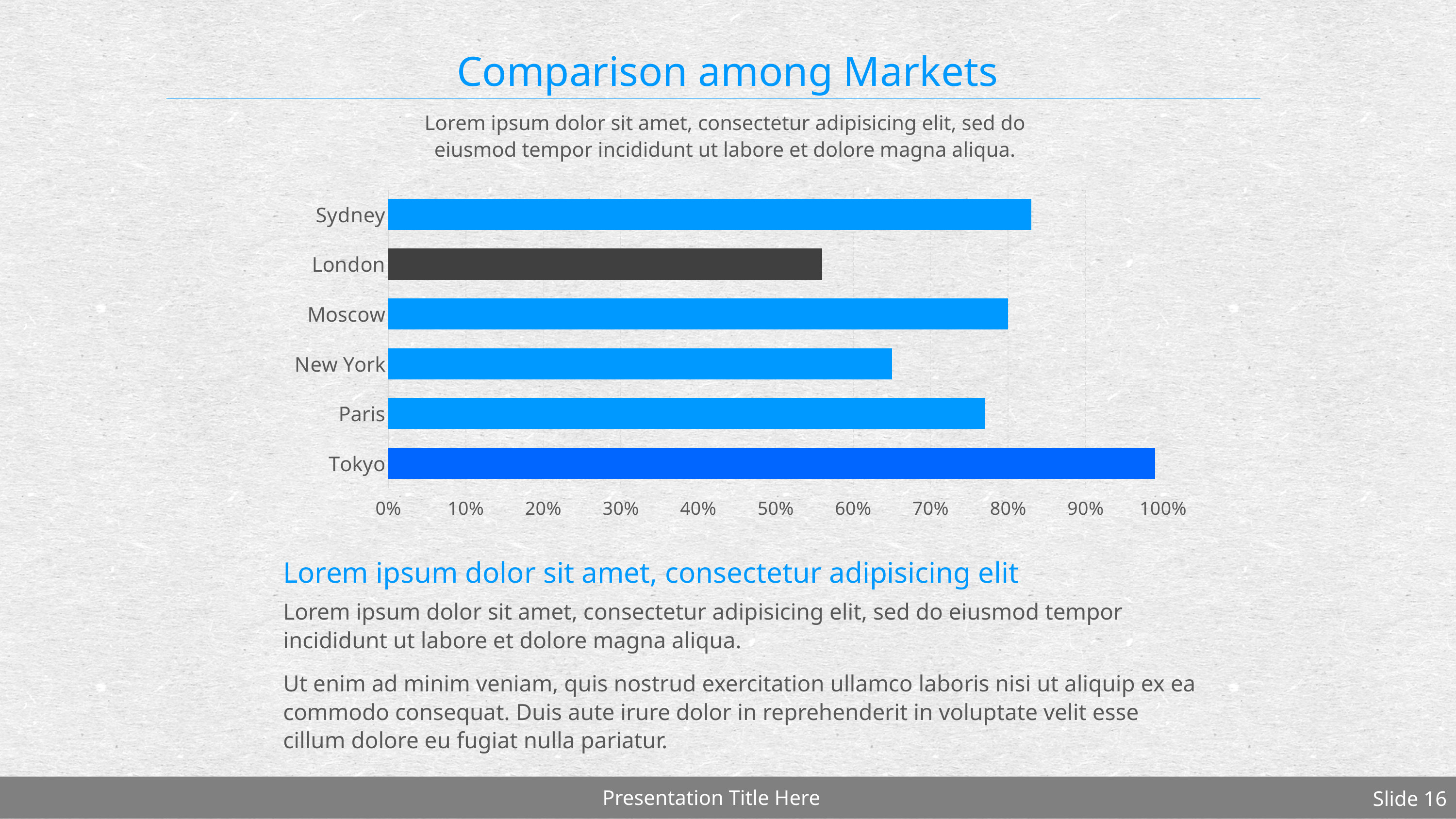
Which market has the highest value in the chart? Tokyo What kind of chart is shown on the slide? bar chart Is the value for London greater or less than 50%? greater Which has the larger value, Sydney or London? Sydney Which market has the lowest value in the chart? London Is the value for Paris greater or less than 70%? greater How many markets (categories) are plotted in the chart? 6 Is the value for Tokyo greater or less than 90%? greater Which has the larger value, Paris or New York? Paris What is the title of the slide containing the chart? Comparison among Markets